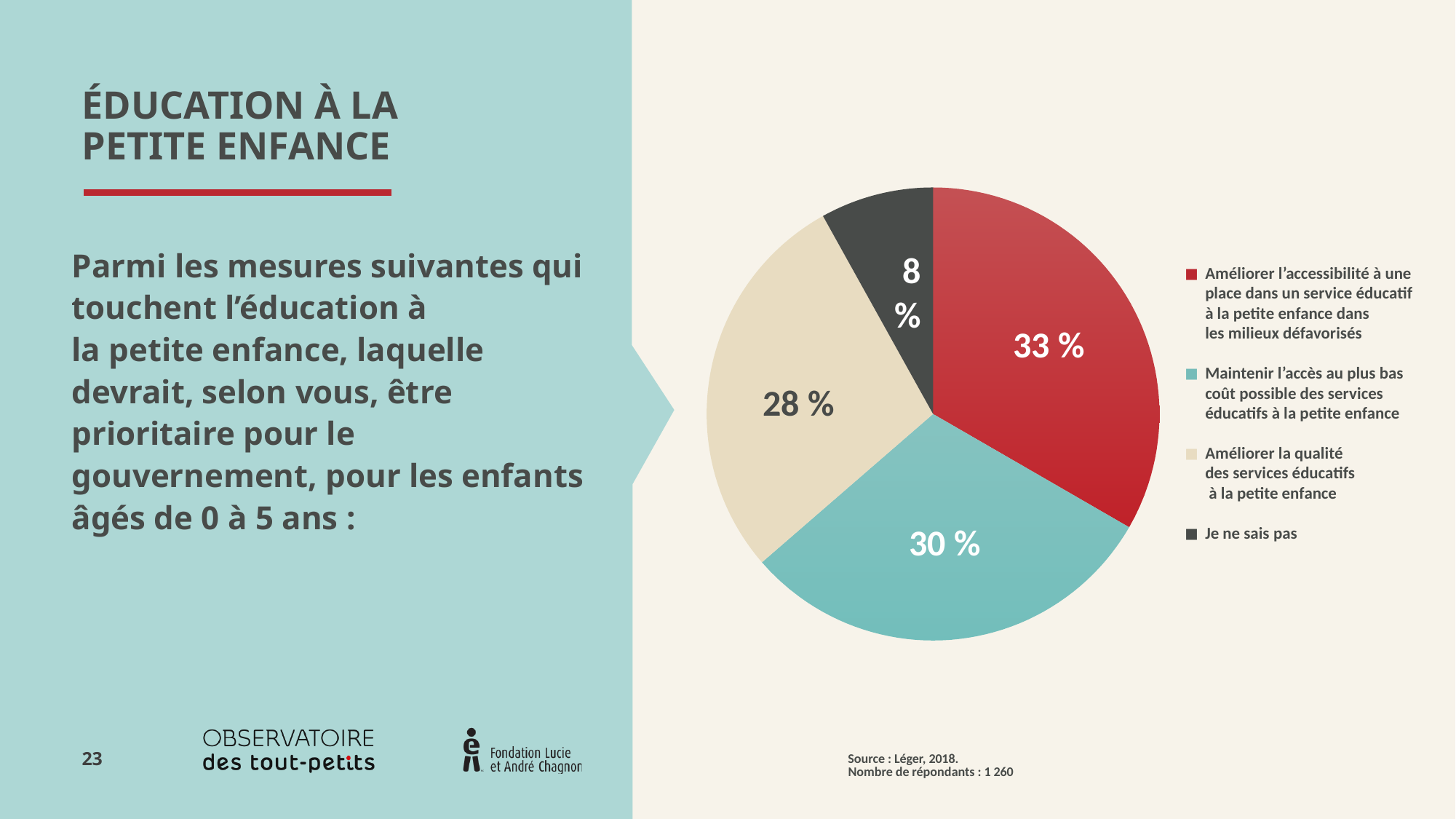
What share of respondents answered "Je ne sais pas"? 8 % What share of respondents chose "Maintenir l'accès au plus bas coût possible des services éducatifs à la petite enfance"? 30 % What share of respondents chose "Améliorer la qualité des services éducatifs à la petite enfance"? 28 % What colour is the slice for "Je ne sais pas"? Dark grey How many slices does the pie chart have? 4 Which is larger: the share for "Maintenir l'accès au plus bas coût possible" or the share for "Améliorer la qualité des services éducatifs"? Maintenir l'accès au plus bas coût possible des services éducatifs à la petite enfance What kind of chart is shown on the slide? Pie chart How many entries does the legend list? 4 Which response has the smallest share of the pie? Je ne sais pas What share of respondents chose "Améliorer l'accessibilité à une place dans un service éducatif à la petite enfance dans les milieux défavorisés"? 33 % What is the difference in percentage points between the largest slice and the "Je ne sais pas" slice? 25 Which response has the largest share of the pie? Améliorer l'accessibilité à une place dans un service éducatif à la petite enfance dans les milieux défavorisés